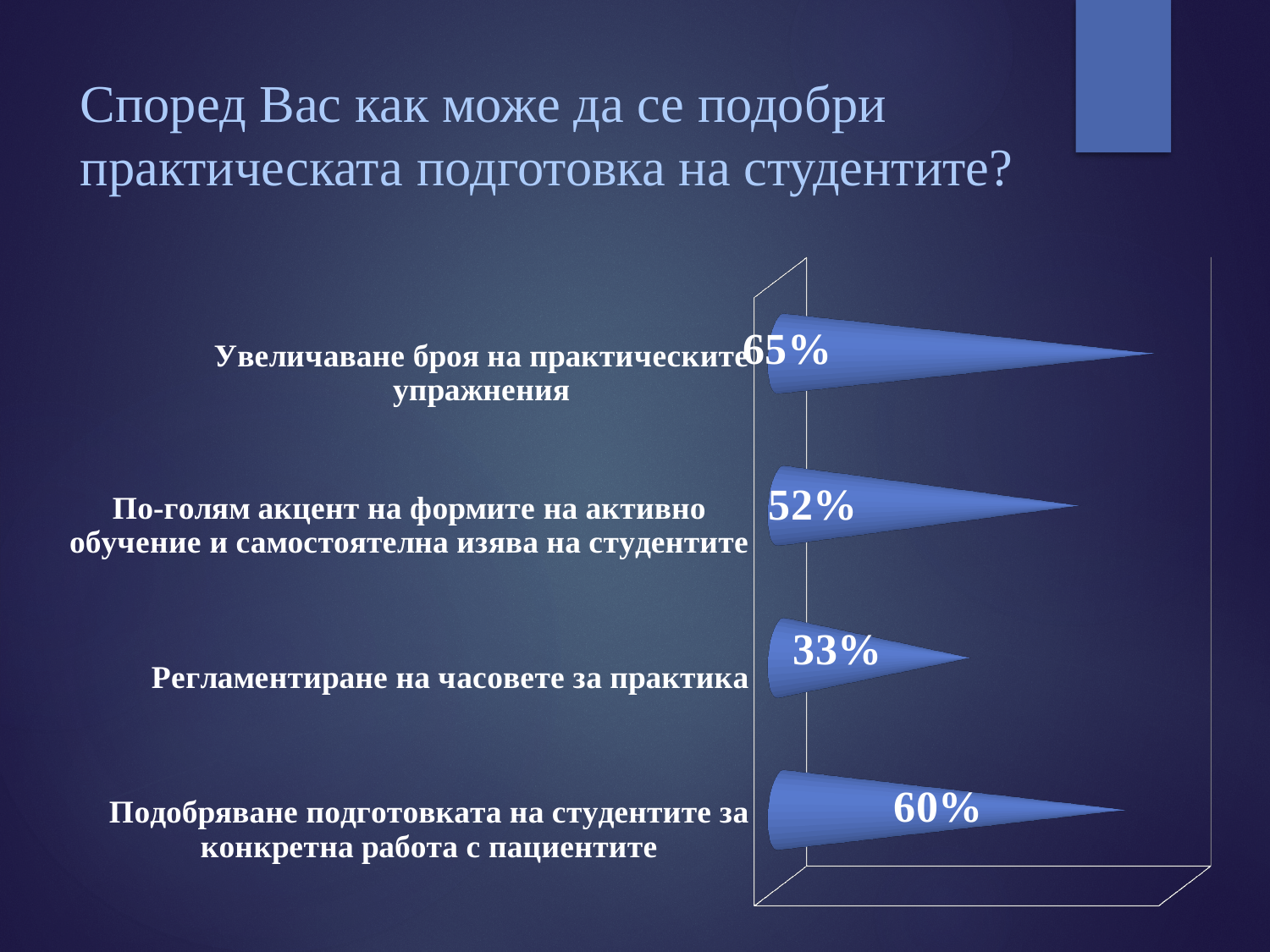
What is the value for "Увеличаване броя на практическите упражнения"? 65% What is the difference between the highest value (65%) and the lowest value (33%)? 32 percentage points What is the difference between the values for "Подобряване подготовката на студентите за конкретна работа с пациентите" and "По-голям акцент на формите на активно обучение и самостоятелна изява на студентите"? 8 percentage points Which category has the lowest value? Регламентиране на часовете за практика What is the title of the slide? Според Вас как може да се подобри практическата подготовка на студентите? What is the value for "Регламентиране на часовете за практика"? 33% Which is larger: the value for "Увеличаване броя на практическите упражнения" or the value for "Подобряване подготовката на студентите за конкретна работа с пациентите"? Увеличаване броя на практическите упражнения Which category has the highest value? Увеличаване броя на практическите упражнения What kind of chart is shown on the slide? Bar chart How many categories are shown in the chart? 4 What is the value for "По-голям акцент на формите на активно обучение и самостоятелна изява на студентите"? 52% What is the value for "Подобряване подготовката на студентите за конкретна работа с пациентите"? 60%